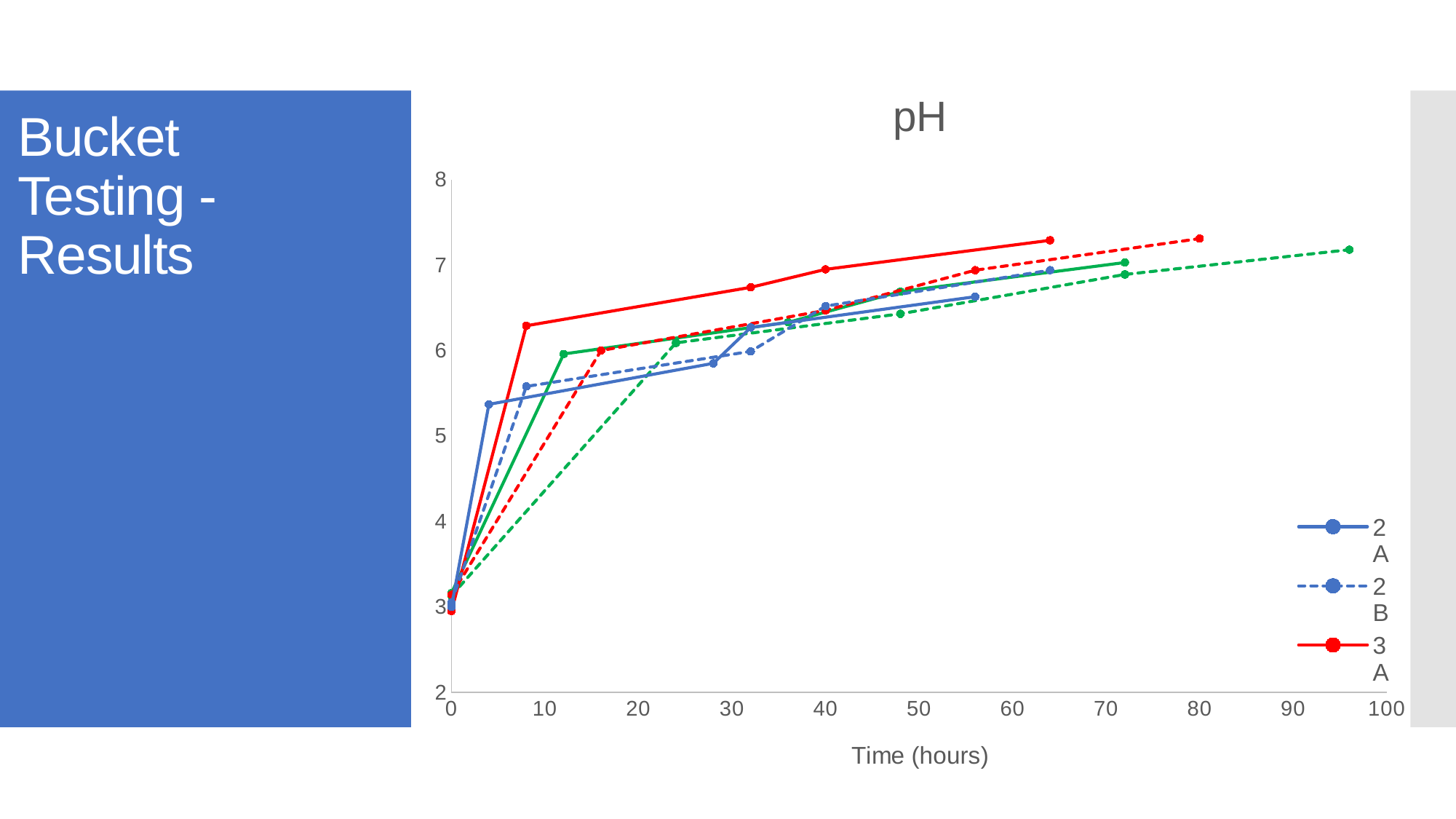
Is the pH value for series 3A at 64 hours greater or less than 7? greater Which series reaches the highest pH at 64 hours, 2A or 3A? 3A What type of chart is shown on the slide? line chart Is the pH value for series 3A at 8 hours greater or less than 6? greater At 8 hours, which series has the higher pH, 2B or 3A? 3A What is the label of the x axis? Time (hours) Is the pH value for series 2B at 56 hours greater or less than 7? less What is the title of the chart? pH Do the pH values generally rise or fall as time increases? rise How many series are listed in the visible legend? 3